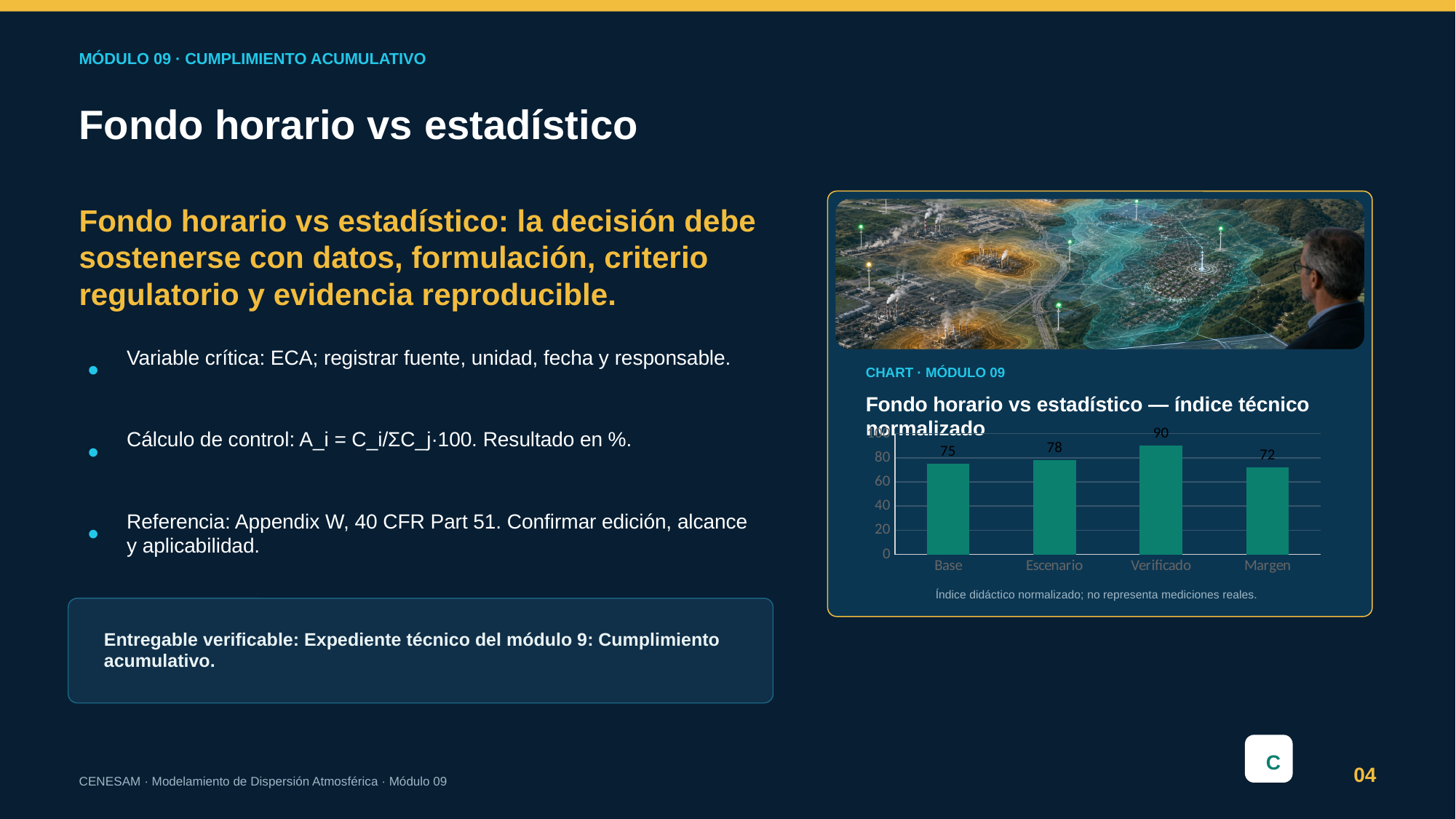
Which is larger, the value for Base or the value for Verificado? Verificado What is the value for Verificado? 90 What is the value for Margen? 72 What is the difference between the values for Verificado and Margen? 18 Which category has the highest value? Verificado What is the value for Escenario? 78 Which category has the lowest value? Margen What is the difference between the values for Escenario and Base? 3 What kind of chart is shown on the slide? bar chart What is the value for Base? 75 How many categories are shown on the x axis? 4 Is the value for Margen greater or less than 80? less